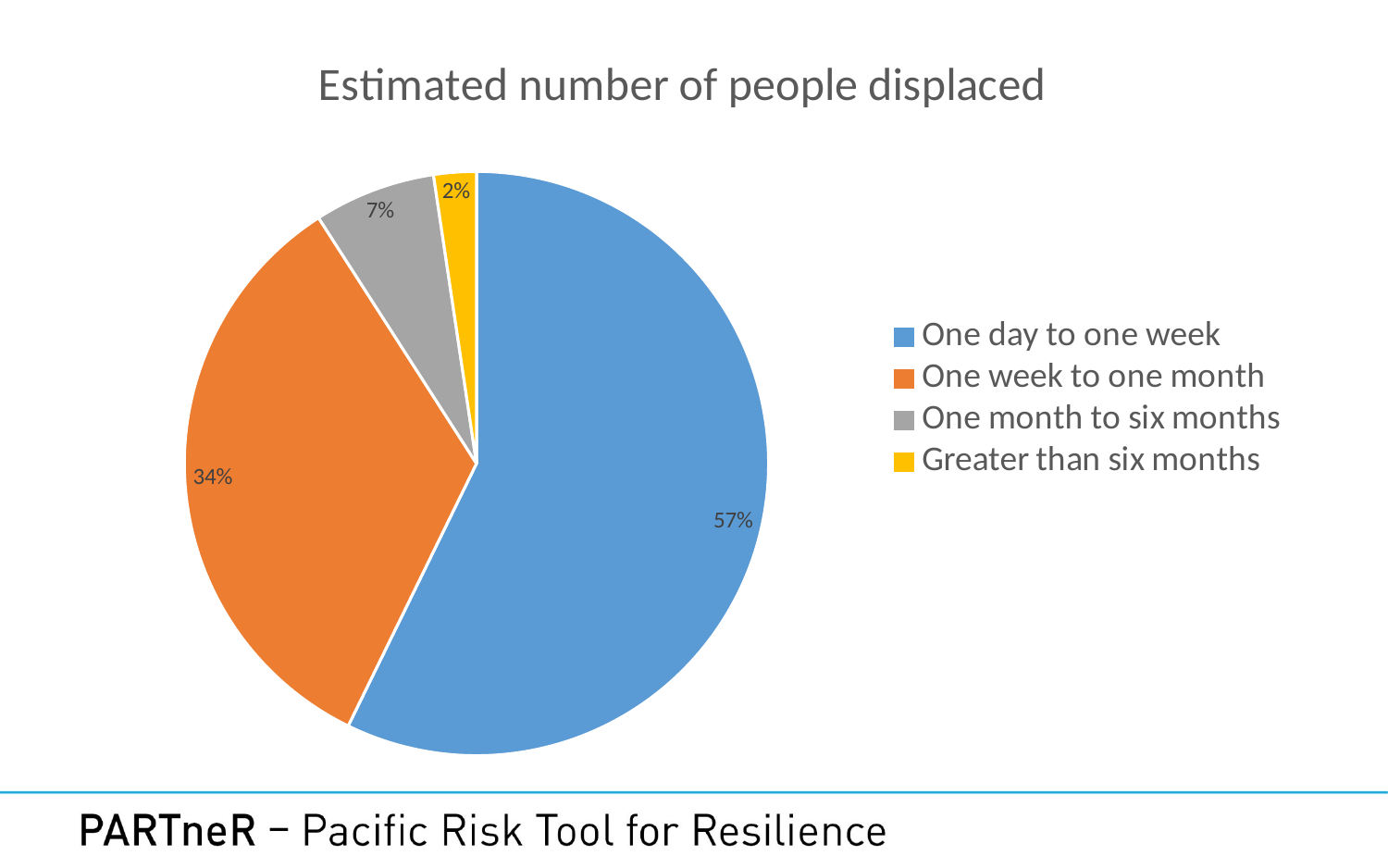
What is the difference in percentage points between 'One day to one week' and 'One week to one month'? 23 percentage points Which category has the largest share of the pie? One day to one week How many categories does the pie chart show? 4 What share of the pie is 'One day to one week'? 57% What share of the pie is 'Greater than six months'? 2% Which is larger, the share for 'One month to six months' or the share for 'Greater than six months'? One month to six months What is the title of the chart? Estimated number of people displaced What colour is the slice for 'Greater than six months'? Yellow What share of the pie is 'One week to one month'? 34% Which category has the smallest share of the pie? Greater than six months What type of chart is shown on the slide? Pie chart